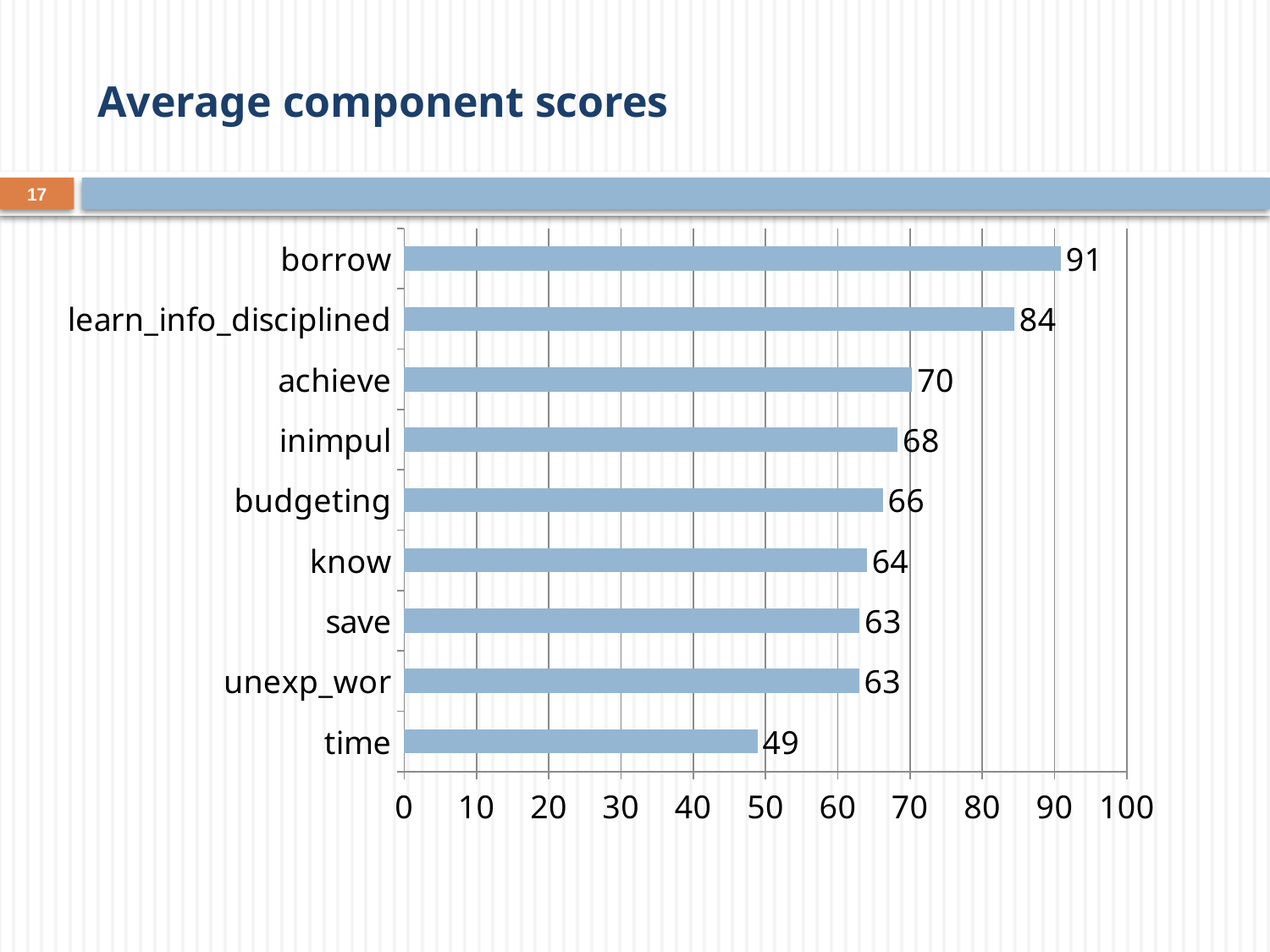
Which component has the highest average score? borrow What is the difference between the scores for borrow and time? 42 What is the average component score for time? 49 What is the title of the slide? Average component scores Which has a higher score, know or achieve? achieve How many components are shown in the chart? 9 Which component has the lowest average score? time What is the average component score for borrow? 91 What is the average component score for budgeting? 66 What is the difference between the scores for achieve and inimpul? 2 What kind of chart is shown on the slide? bar chart What is the average component score for learn_info_disciplined? 84